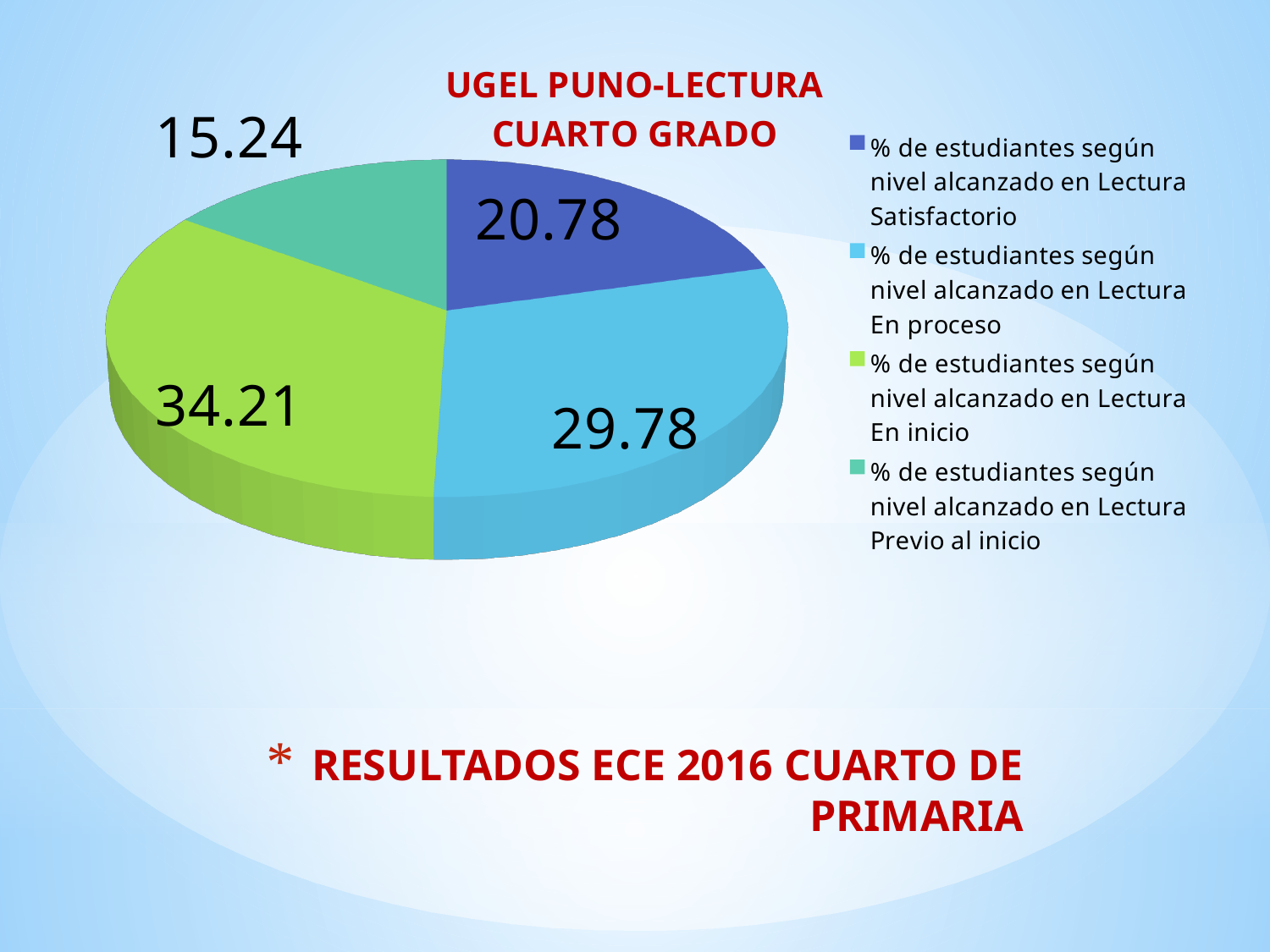
Which level has the smallest slice of the pie? Previo al inicio What is the value for the 'En inicio' slice? 34.21 What colour is the 'En inicio' slice? green Which level has the largest slice of the pie? En inicio What kind of chart is shown on the slide? pie chart What is the value for the 'Satisfactorio' slice? 20.78 What is the value for the 'En proceso' slice? 29.78 Which is larger, the 'En proceso' value or the 'Satisfactorio' value? En proceso How many slices does the pie chart have? 4 What is the value for the 'Previo al inicio' slice? 15.24 What is the difference between the 'En inicio' value and the 'Satisfactorio' value? 13.43 What is the title of the chart? UGEL PUNO-LECTURA CUARTO GRADO